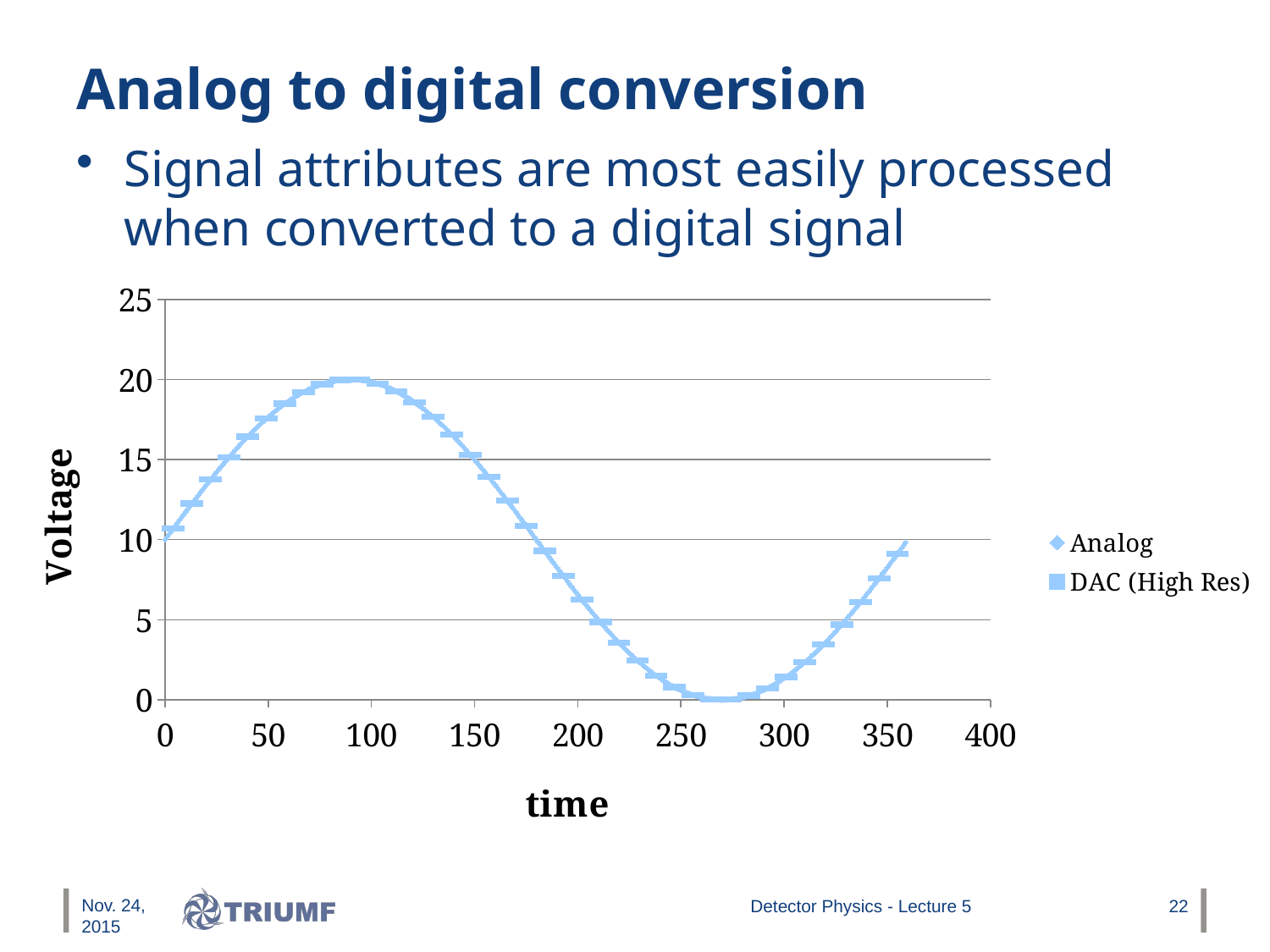
What is the label of the vertical axis? Voltage What kind of chart is shown on the slide? Scatter (line) chart How many series does the legend list? 2 Is the Voltage value at time 200 greater or less than 10? less Which is larger, the Voltage at time 100 or the Voltage at time 300? time 100 What are the two series named in the legend? Analog and DAC (High Res) Is the Voltage value at time 50 greater or less than 15? greater Is the Voltage value at time 0 greater or less than 5? greater Do the Voltage values rise or fall as time goes from 100 to 250? fall Do the Voltage values rise or fall as time goes from 0 to 90? rise